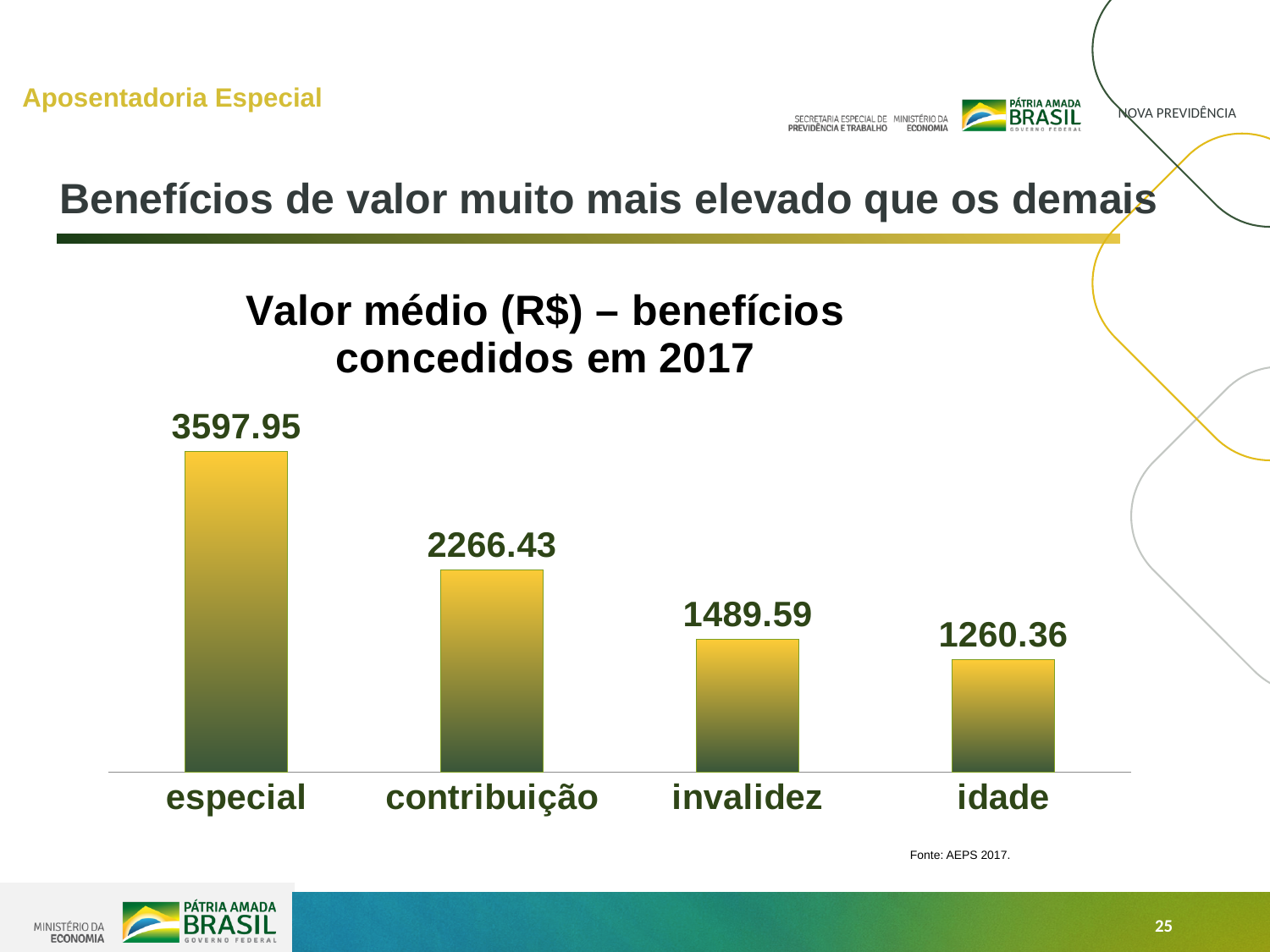
Which benefit category has the highest average value? especial What is the average value (R$) for the 'especial' benefit? 3597.95 What is the average value (R$) for the 'invalidez' benefit? 1489.59 How many benefit categories are shown in the chart? 4 What type of chart is shown on the slide? Bar chart What is the difference between the average value for 'especial' and for 'contribuição'? 1331.52 What is the average value (R$) for the 'idade' benefit? 1260.36 What is the title of the chart? Valor médio (R$) – benefícios concedidos em 2017 What is the difference between the average value for 'invalidez' and for 'idade'? 229.23 Which has a larger average value, 'contribuição' or 'invalidez'? contribuição What is the average value (R$) for the 'contribuição' benefit? 2266.43 Which benefit category has the lowest average value? idade